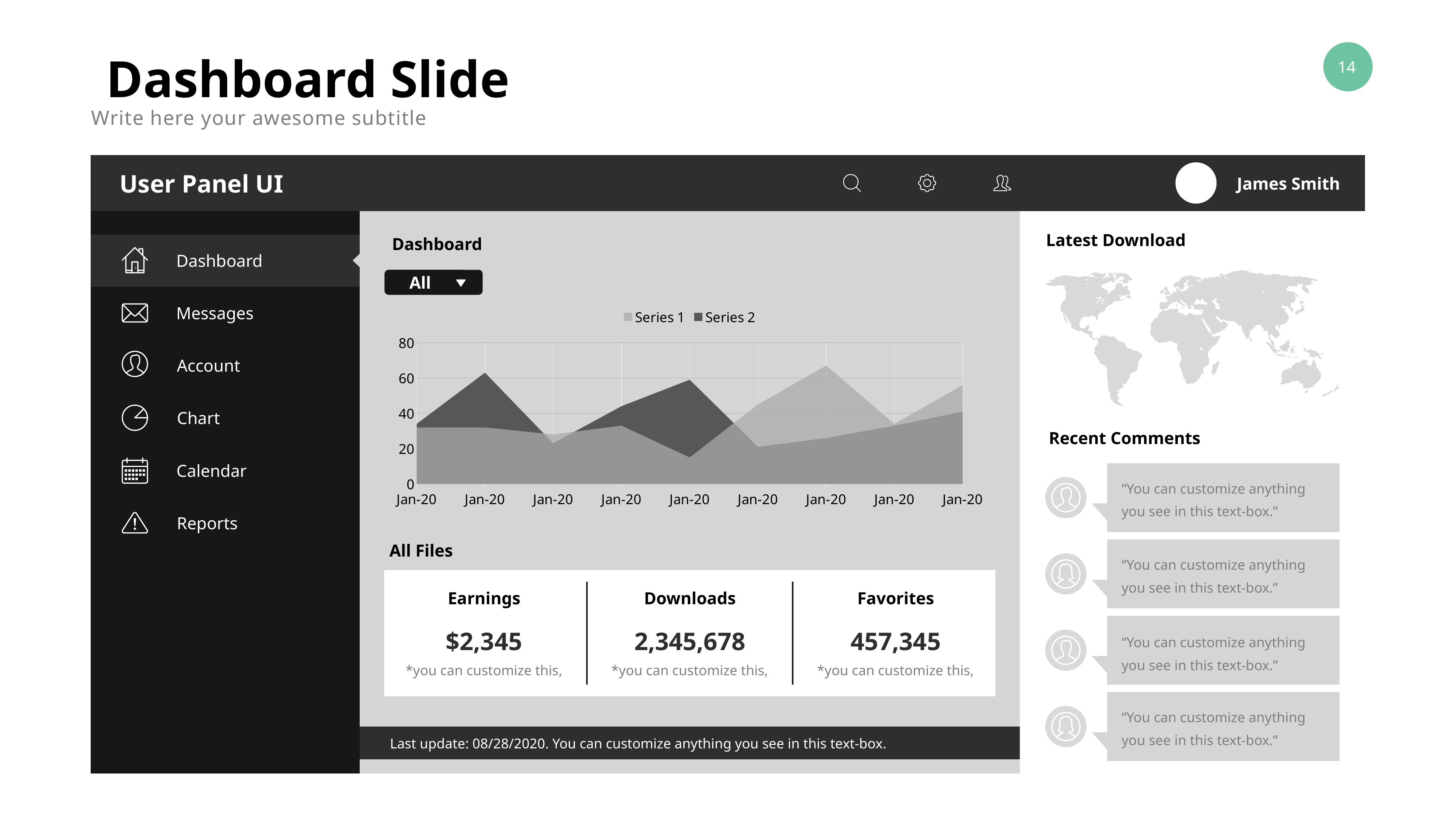
Is the Series 1 value at the seventh point from the left greater or less than 60? greater What kind of chart is shown in the Dashboard panel? area chart What are the two series names shown in the chart legend? Series 1 and Series 2 At the second point from the left, which series has the larger value, Series 1 or Series 2? Series 2 Is the Series 2 value at the second point from the left greater or less than 40? greater At which point from the left does Series 1 reach its highest value? the seventh point How many data points are plotted along the x axis of the chart? 9 How many series does the chart legend list? 2 At the seventh point from the left, which series has the larger value, Series 1 or Series 2? Series 1 Is the Series 2 value at the fifth point from the left greater or less than 40? greater What is the highest value shown on the chart's y axis? 80